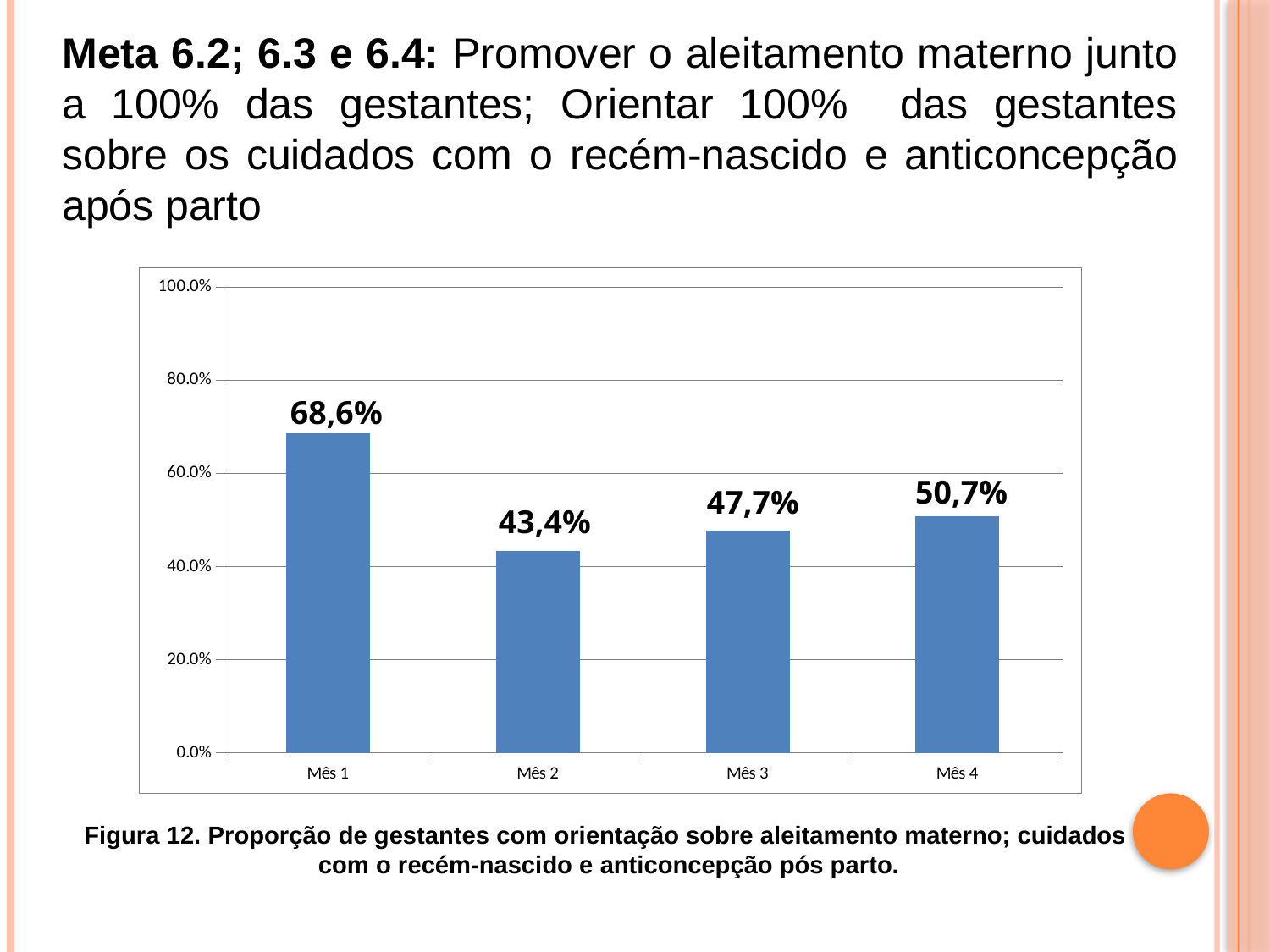
Is the value for Mês 2 greater or less than 40.0%? greater What is the difference between the values for Mês 1 and Mês 2? 25,2% Which month has the lowest value? Mês 2 How many months are shown on the x axis? 4 Which month has the highest value? Mês 1 Which is larger, the value for Mês 3 or the value for Mês 4? Mês 4 What is the value for Mês 2? 43,4% What is the value for Mês 1? 68,6% What is the value for Mês 4? 50,7% What is the value for Mês 3? 47,7% What is the difference between the values for Mês 4 and Mês 3? 3,0% What kind of chart is shown on the slide? bar chart